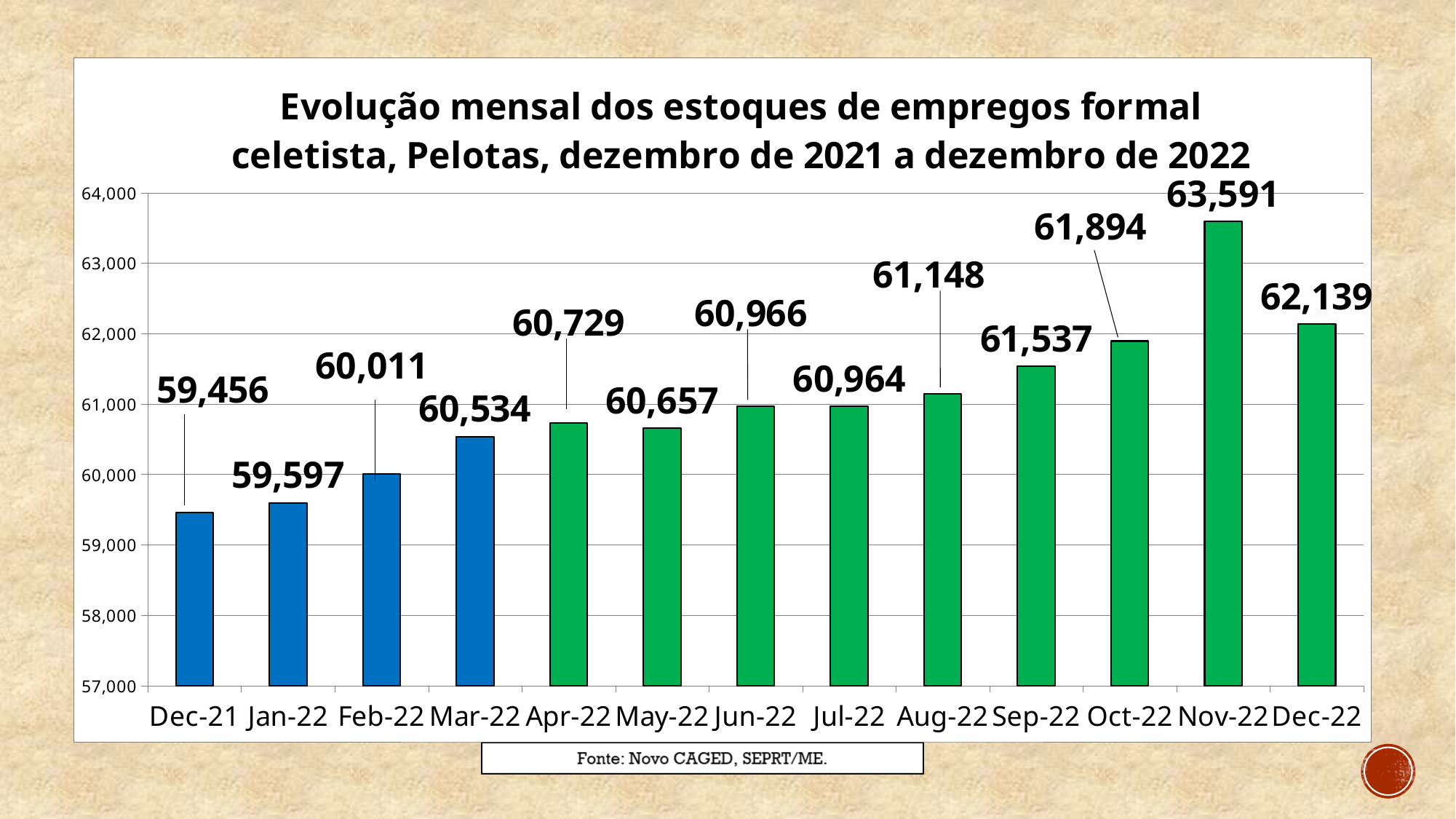
What is the value for Aug-22? 61,148 What is the value for Nov-22? 63,591 How many months are shown on the x axis? 13 What kind of chart is shown on the slide? bar chart What is the difference between the values for Nov-22 and Dec-22? 1,452 What is the difference between the values for Dec-22 and Dec-21? 2,683 Is the value for Oct-22 greater or less than 62,000? less Which is larger, the value for Apr-22 or the value for May-22? Apr-22 Which month has the lowest value? Dec-21 How many bars are coloured blue rather than green? 4 What is the value for Dec-21? 59,456 Which month has the highest value? Nov-22